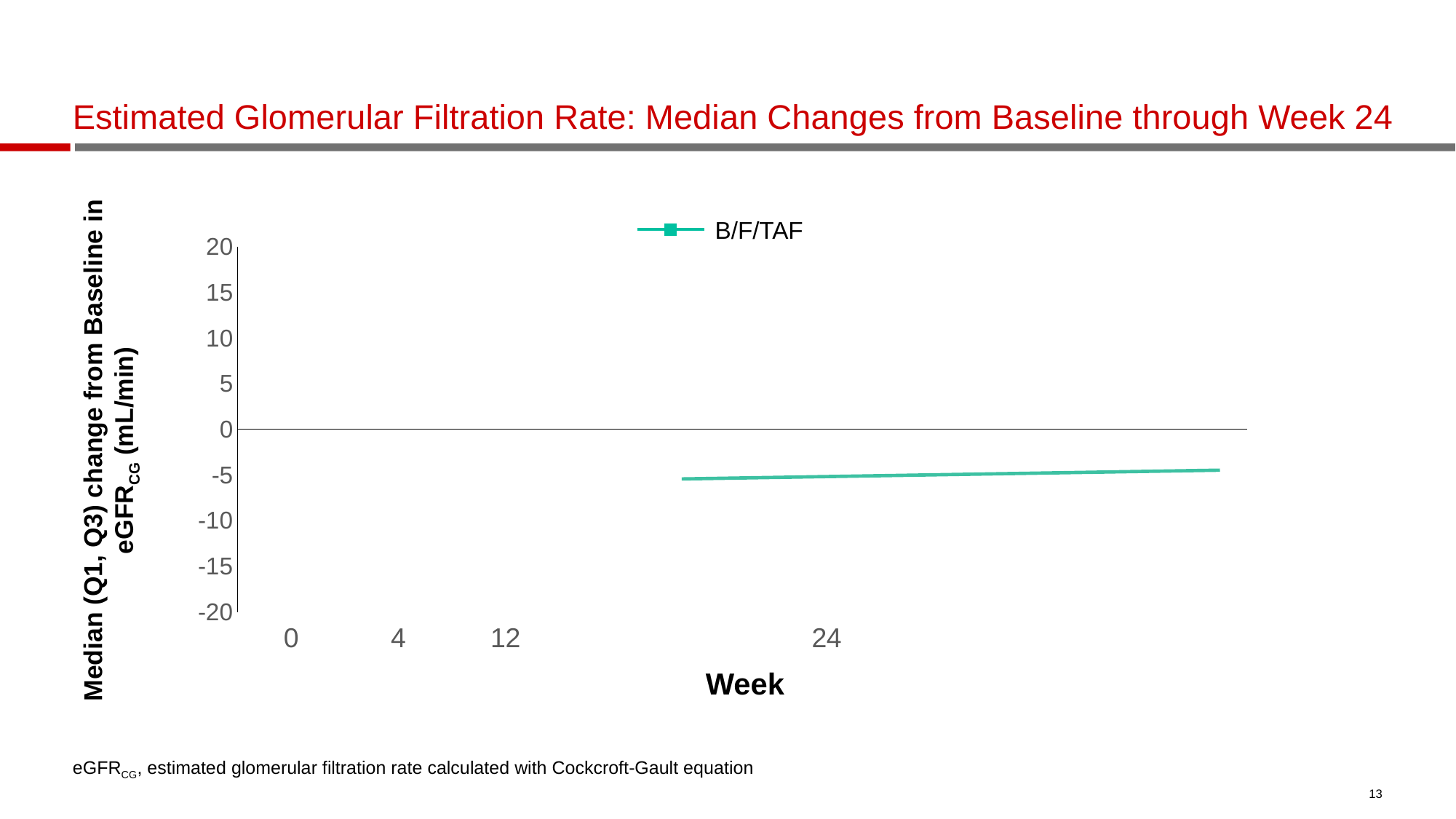
Is the value for B/F/TAF at week 24 greater or less than 5? less What is the label of the x axis? Week Is the value for B/F/TAF at week 24 greater or less than -10? greater What kind of chart is shown on the slide? line chart What is the name of the series shown in the legend? B/F/TAF How many series does the legend list? 1 Is the value for B/F/TAF at week 24 greater or less than 0? less